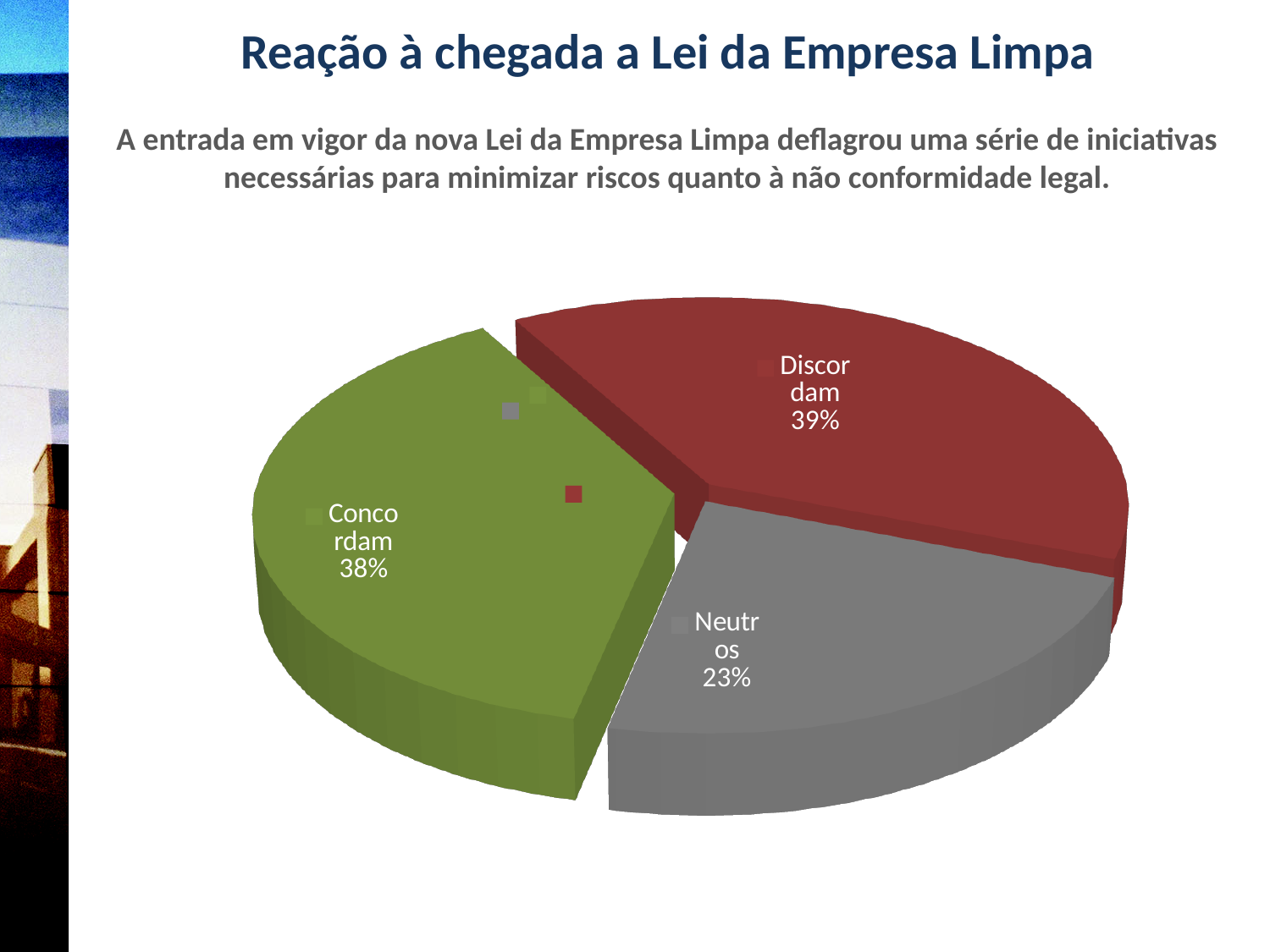
What share of the pie does the Discordam slice represent? 39% Which slice of the pie is the smallest? Neutros Which slice of the pie is the largest? Discordam What kind of chart is shown on the slide? pie chart What share of the pie does the Concordam slice represent? 38% Which is larger, the Concordam slice or the Neutros slice? Concordam What is the title of the slide containing the pie chart? Reação à chegada a Lei da Empresa Limpa What colour is the Neutros slice of the pie chart? grey What is the difference in percentage points between the Discordam and Neutros slices? 16 What share of the pie does the Neutros slice represent? 23% What is the difference in percentage points between the Concordam and Neutros slices? 15 How many slices does the pie chart have? 3